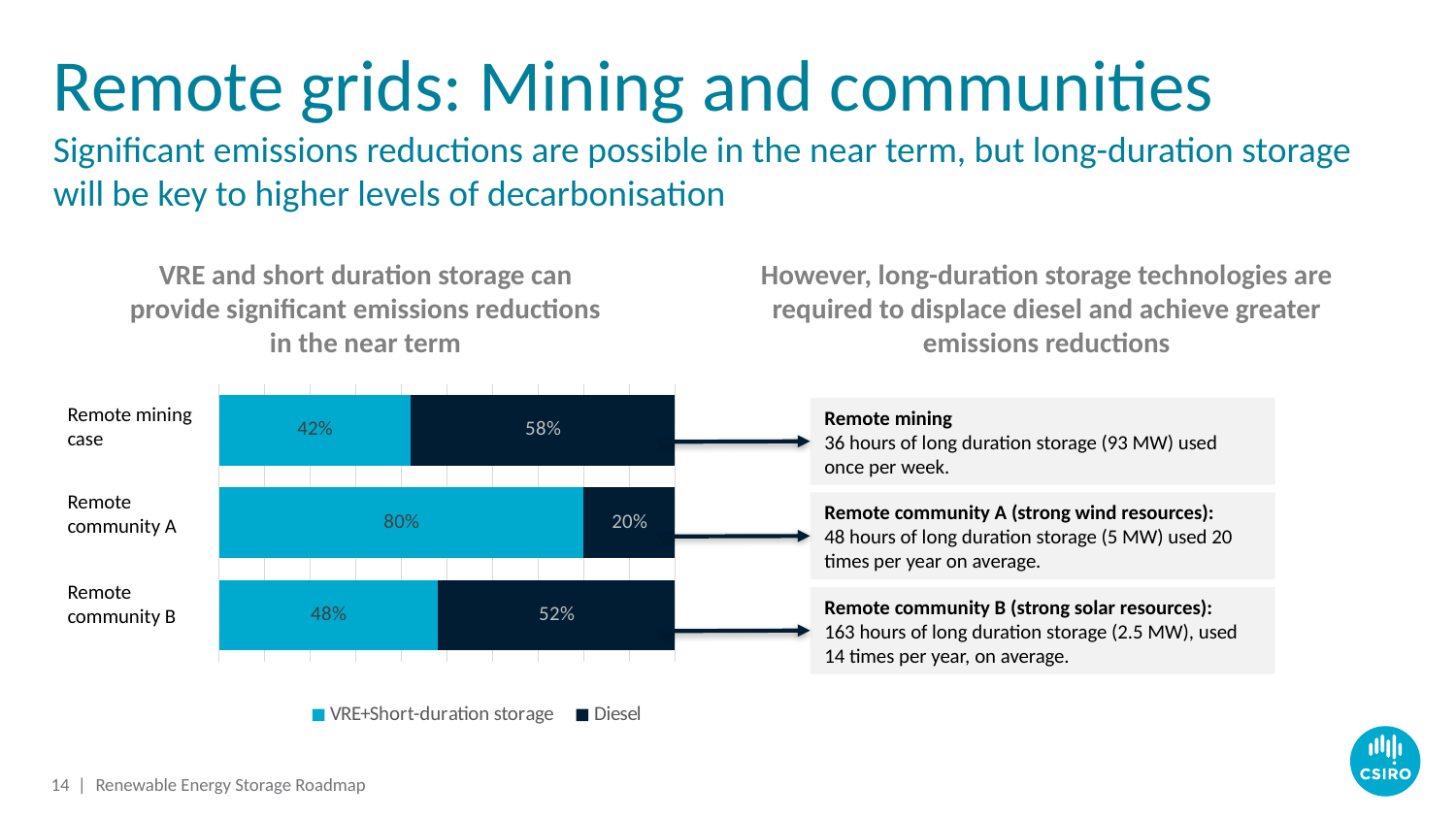
Which is larger: the VRE+Short-duration storage share for Remote community B or for the Remote mining case? Remote community B How many series does the legend list? 2 Which category has the lowest Diesel share? Remote community A What is the Diesel share for the Remote mining case? 58% What is the VRE+Short-duration storage share for Remote community A? 80% Which series is shown in dark navy in the chart? Diesel What is the total of the stacked bar for Remote community B? 100% What kind of chart is shown on the slide? Stacked bar chart Which category has the highest VRE+Short-duration storage share? Remote community A How many categories are shown in the chart? 3 What is the Diesel share for Remote community B? 52% What is the difference between the Diesel share of the Remote mining case and that of Remote community A? 38%